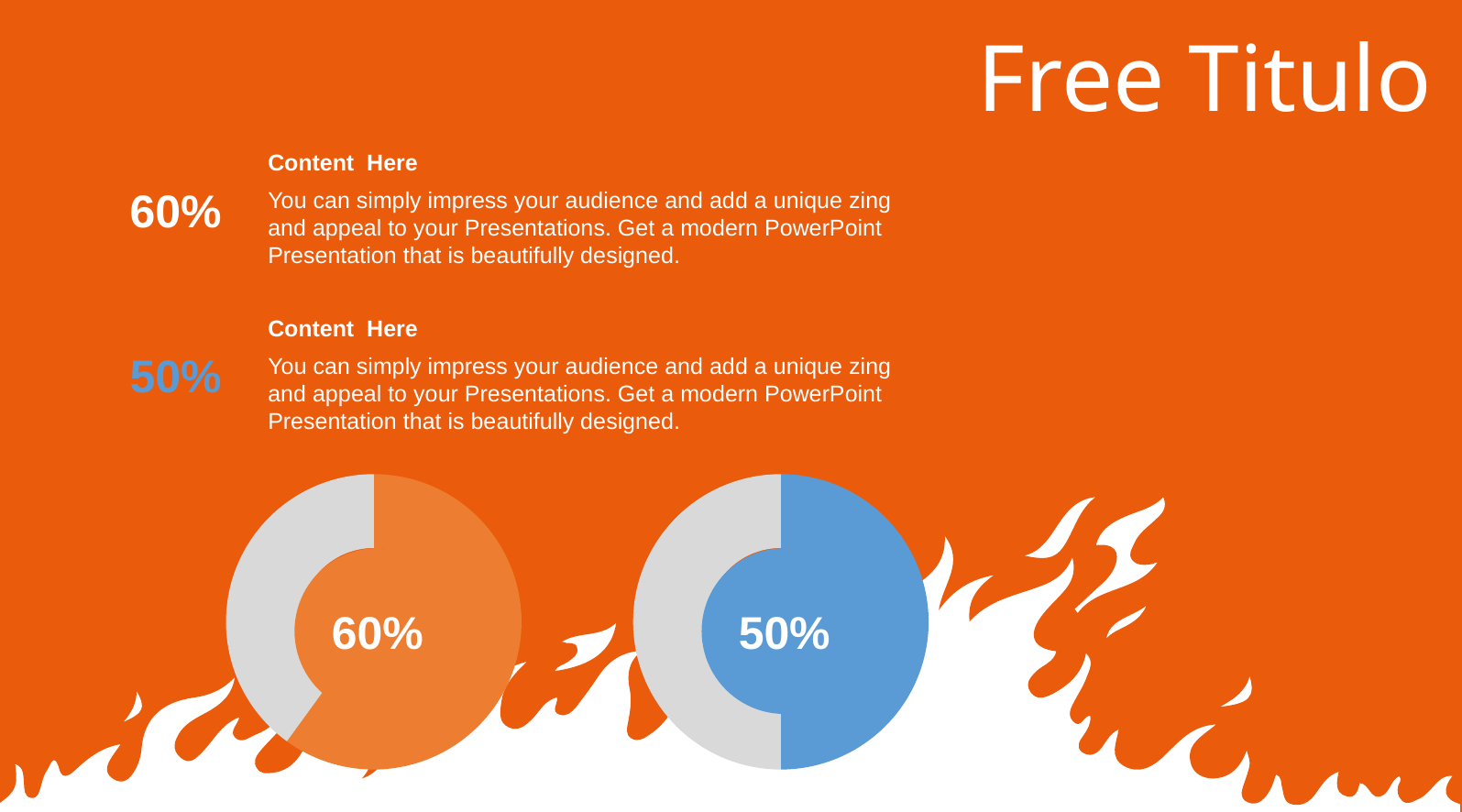
What is the difference between the value in the left donut chart and the value in the right donut chart? 10 percentage points Which donut chart shows the larger value, the left one or the right one? The left one (60%) How many donut charts are shown on the slide? 2 What value is printed in the centre of the right donut chart? 50% What colour is the filled portion of the right donut chart? Blue What kind of chart is the right chart on the slide? Donut chart In the left donut chart, what share of the ring is left grey? 40% In the left donut chart, what share of the ring is filled with orange? 60% In the right donut chart, what share of the ring is filled with blue? 50% What colour is the filled portion of the left donut chart? Orange What value is printed in the centre of the left donut chart? 60% What kind of chart is the left chart on the slide? Donut chart